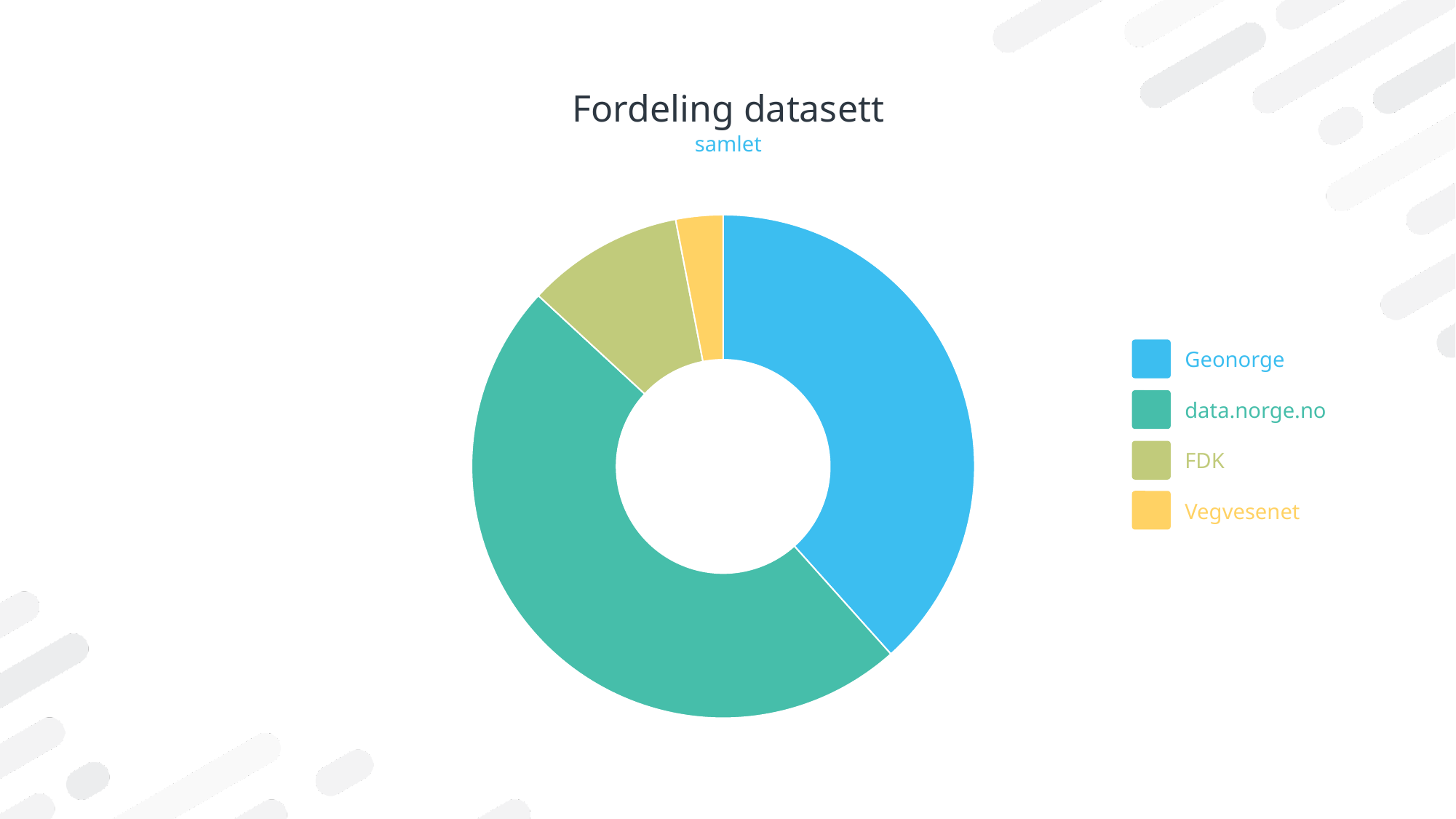
Which has the larger share, Geonorge or FDK? Geonorge Which has the larger share, FDK or Vegvesenet? FDK What is the title of the chart? Fordeling datasett Which category has the smallest share of the chart? Vegvesenet Which category has the largest share of the chart? data.norge.no Which has the larger share, data.norge.no or Vegvesenet? data.norge.no What colour represents Geonorge in the chart? Blue What kind of chart is shown on the slide? Pie chart (donut) How many categories does the chart show? 4